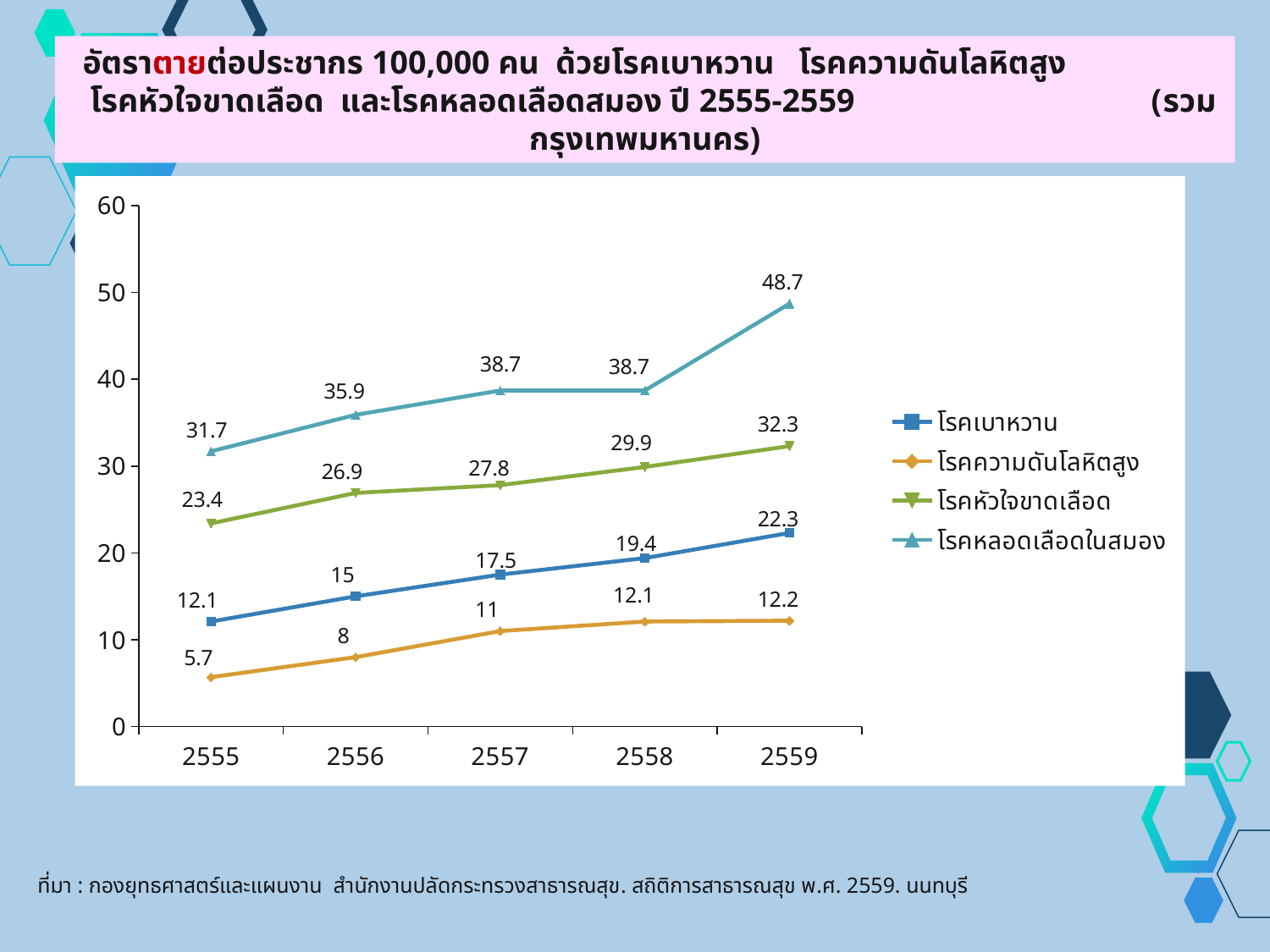
Does the value for โรคเบาหวาน rise or fall from 2555 to 2559? rise How many years are shown on the x axis? 5 In which year is the value for โรคหลอดเลือดในสมอง highest? 2559 What is the value for โรคเบาหวาน in 2557? 17.5 What is the difference between the โรคหลอดเลือดในสมอง values in 2559 and 2558? 10 In which year is the value for โรคเบาหวาน lowest? 2555 What is the value for โรคความดันโลหิตสูง in 2555? 5.7 Which is larger in 2556: the value for โรคหัวใจขาดเลือด or the value for โรคเบาหวาน? โรคหัวใจขาดเลือด What type of chart is shown on the slide? line chart What is the value for โรคหัวใจขาดเลือด in 2558? 29.9 How many series does the legend list? 4 What is the value for โรคหลอดเลือดในสมอง in 2559? 48.7